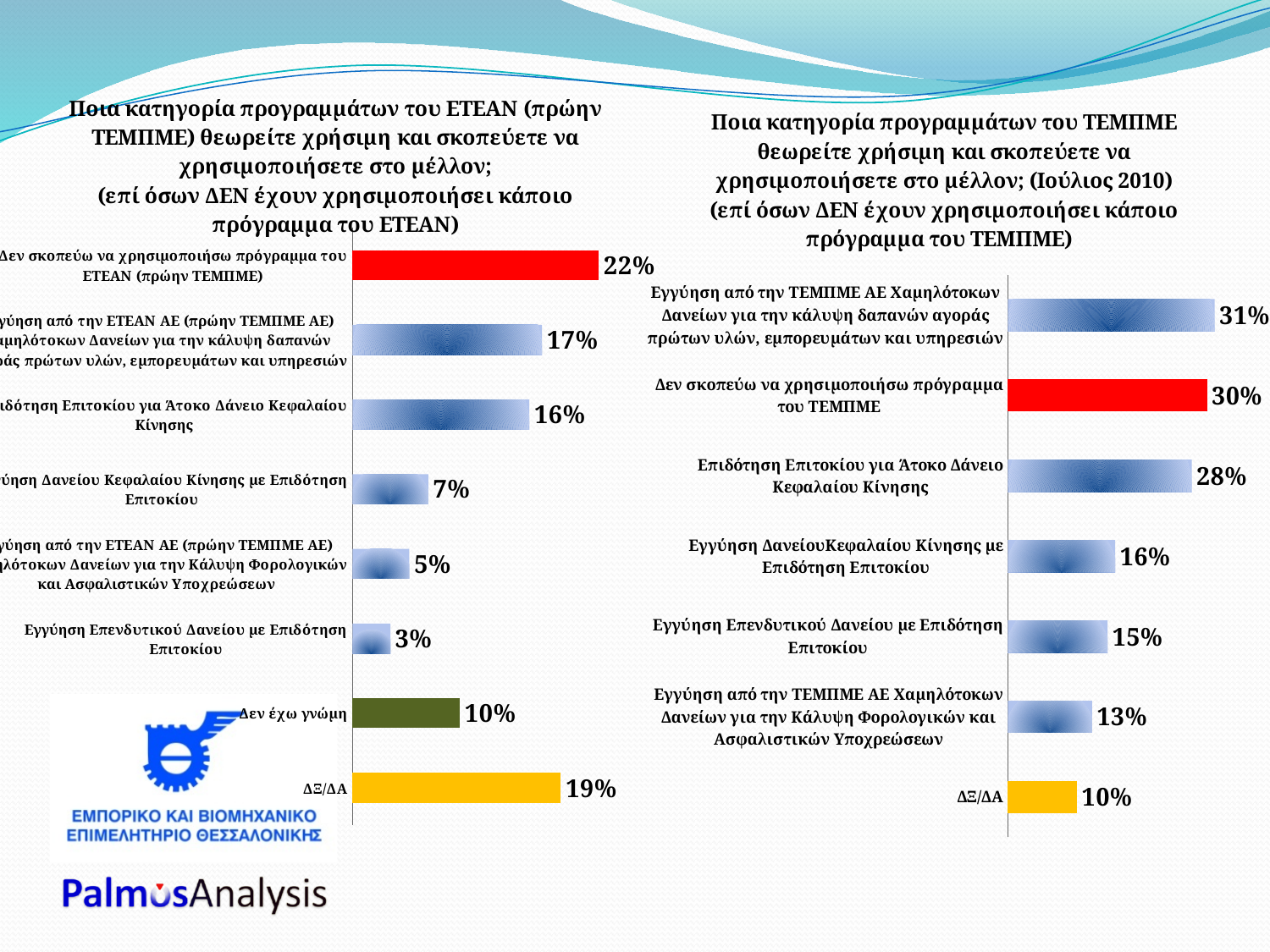
In the right chart (ΤΕΜΠΜΕ, Ιούλιος 2010), which category has the highest value? Εγγύηση από την ΤΕΜΠΜΕ ΑΕ Χαμηλότοκων Δανείων για την κάλυψη δαπανών αγοράς πρώτων υλών, εμπορευμάτων και υπηρεσιών In the right chart (ΤΕΜΠΜΕ, Ιούλιος 2010), which category has the lowest value? ΔΞ/ΔΑ In the left chart (ΕΤΕΑΝ), what is the value for 'ΔΞ/ΔΑ'? 19% In the left chart (ΕΤΕΑΝ), what is the value for 'Εγγύηση Επενδυτικού Δανείου με Επιδότηση Επιτοκίου'? 3% In the left chart (ΕΤΕΑΝ), what is the value for 'Δεν σκοπεύω να χρησιμοποιήσω πρόγραμμα του ΕΤΕΑΝ (πρώην ΤΕΜΠΜΕ)'? 22% What type of chart is the left chart (ΕΤΕΑΝ)? Bar chart In the right chart (ΤΕΜΠΜΕ, Ιούλιος 2010), what is the value for 'Εγγύηση Επενδυτικού Δανείου με Επιδότηση Επιτοκίου'? 15% In the right chart (ΤΕΜΠΜΕ, Ιούλιος 2010), what is the difference between 'Επιδότηση Επιτοκίου για Άτοκο Δάνειο Κεφαλαίου Κίνησης' and 'Εγγύηση ΔανείουΚεφαλαίου Κίνησης με Επιδότηση Επιτοκίου'? 12% In the right chart (ΤΕΜΠΜΕ, Ιούλιος 2010), what is the value for 'Δεν σκοπεύω να χρησιμοποιήσω πρόγραμμα του ΤΕΜΠΜΕ'? 30% In the right chart (ΤΕΜΠΜΕ, Ιούλιος 2010), what is the value for 'Εγγύηση από την ΤΕΜΠΜΕ ΑΕ Χαμηλότοκων Δανείων για την κάλυψη δαπανών αγοράς πρώτων υλών, εμπορευμάτων και υπηρεσιών'? 31% In the left chart (ΕΤΕΑΝ), which is larger: 'Δεν έχω γνώμη' or 'ΔΞ/ΔΑ'? ΔΞ/ΔΑ In the right chart (ΤΕΜΠΜΕ, Ιούλιος 2010), how many categories are shown? 7